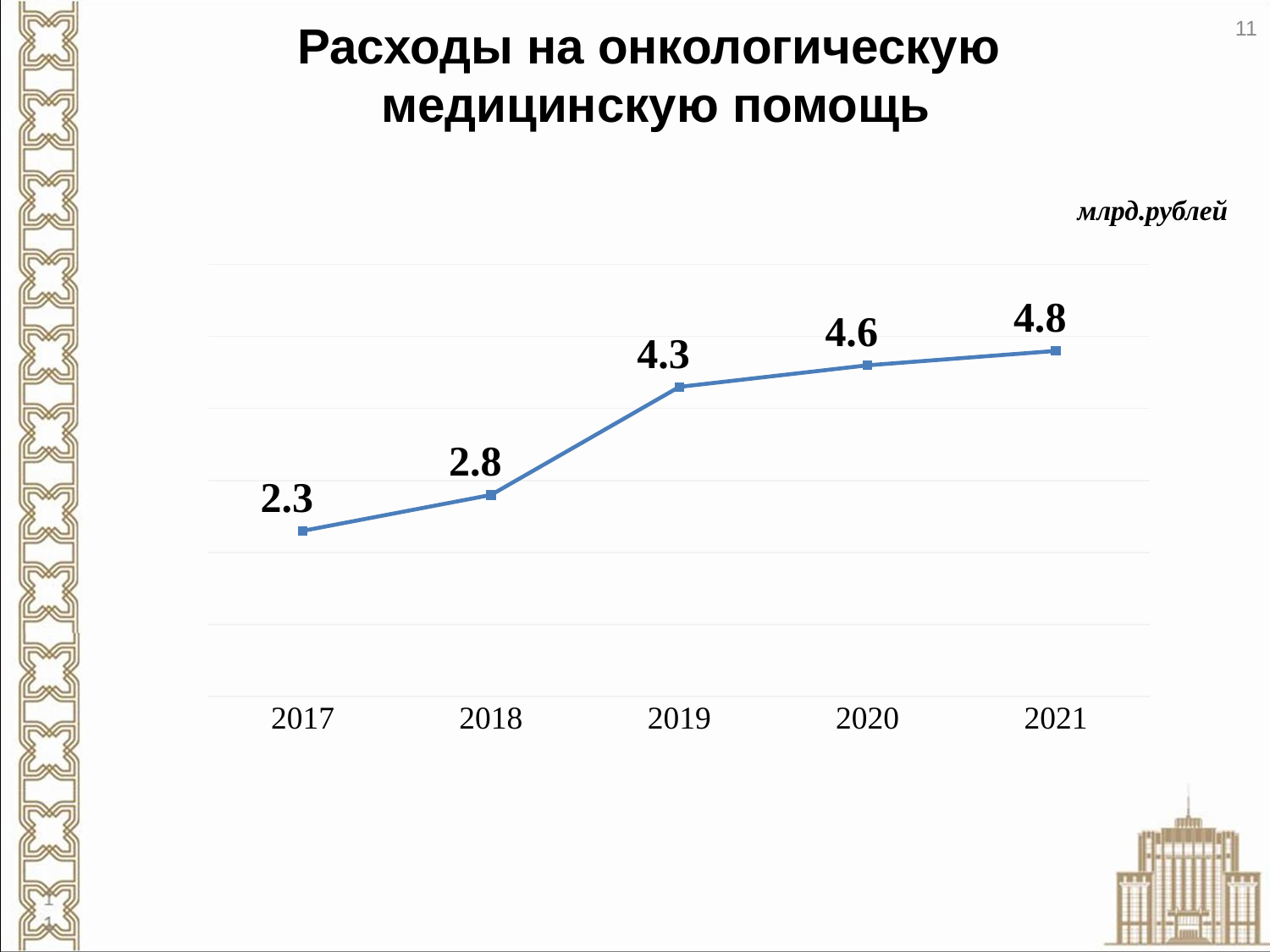
What was the spending on oncological medical care in 2017? 2.3 What unit is indicated for the values on the chart? млрд.рублей Which is larger, the value for 2020 or the value for 2018? 2020 What is the difference between the values for 2019 and 2018? 1.5 What value is shown for 2021? 4.8 By how much did the value increase from 2017 to 2021? 2.5 What value is shown for 2019? 4.3 Which year has the lowest value? 2017 What kind of chart is shown on the slide? line chart How many years are plotted on the chart? 5 Which year has the highest value? 2021 Do the values rise or fall from 2017 to 2021? rise